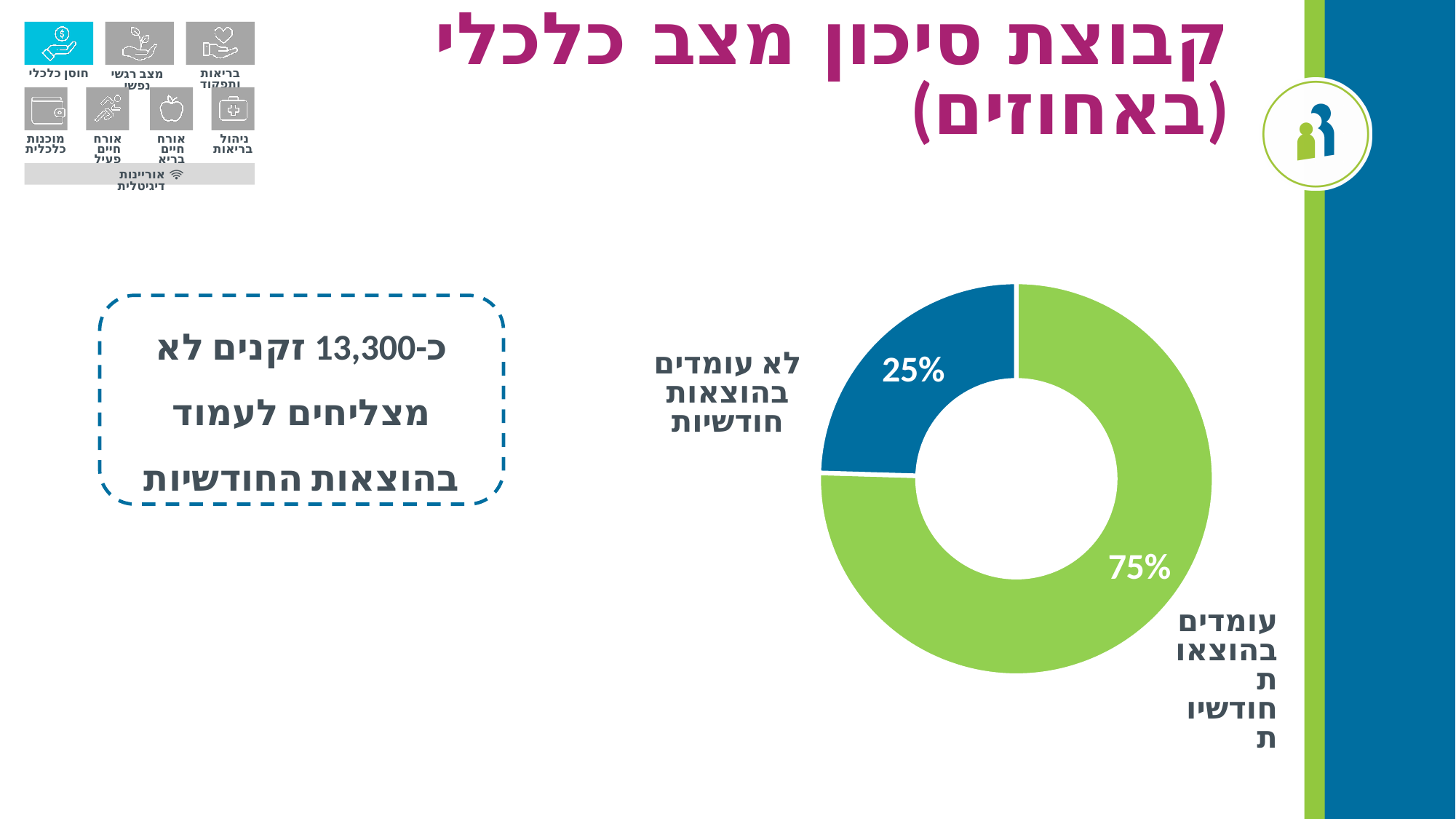
What colour is the slice labelled "עומדים בהוצאות חודשיות"? Green What percentage of the donut chart is labelled "לא עומדים בהוצאות חודשיות"? 25% What is the total of the two slices shown in the donut chart? 100% Which category has the smallest share of the donut chart? לא עומדים בהוצאות חודשיות Which category has the largest share of the donut chart? עומדים בהוצאות חודשיות What kind of chart is shown on the slide? Donut (pie) chart What percentage of the donut chart is labelled "עומדים בהוצאות חודשיות"? 75% How many slices does the donut chart have? 2 What is the difference in percentage points between the "עומדים בהוצאות חודשיות" slice and the "לא עומדים בהוצאות חודשיות" slice? 50 What is the title of the slide containing the donut chart? קבוצת סיכון מצב כלכלי (באחוזים) What share of the donut chart does the blue slice represent? 25% Which slice is larger: "עומדים בהוצאות חודשיות" or "לא עומדים בהוצאות חודשיות"? עומדים בהוצאות חודשיות